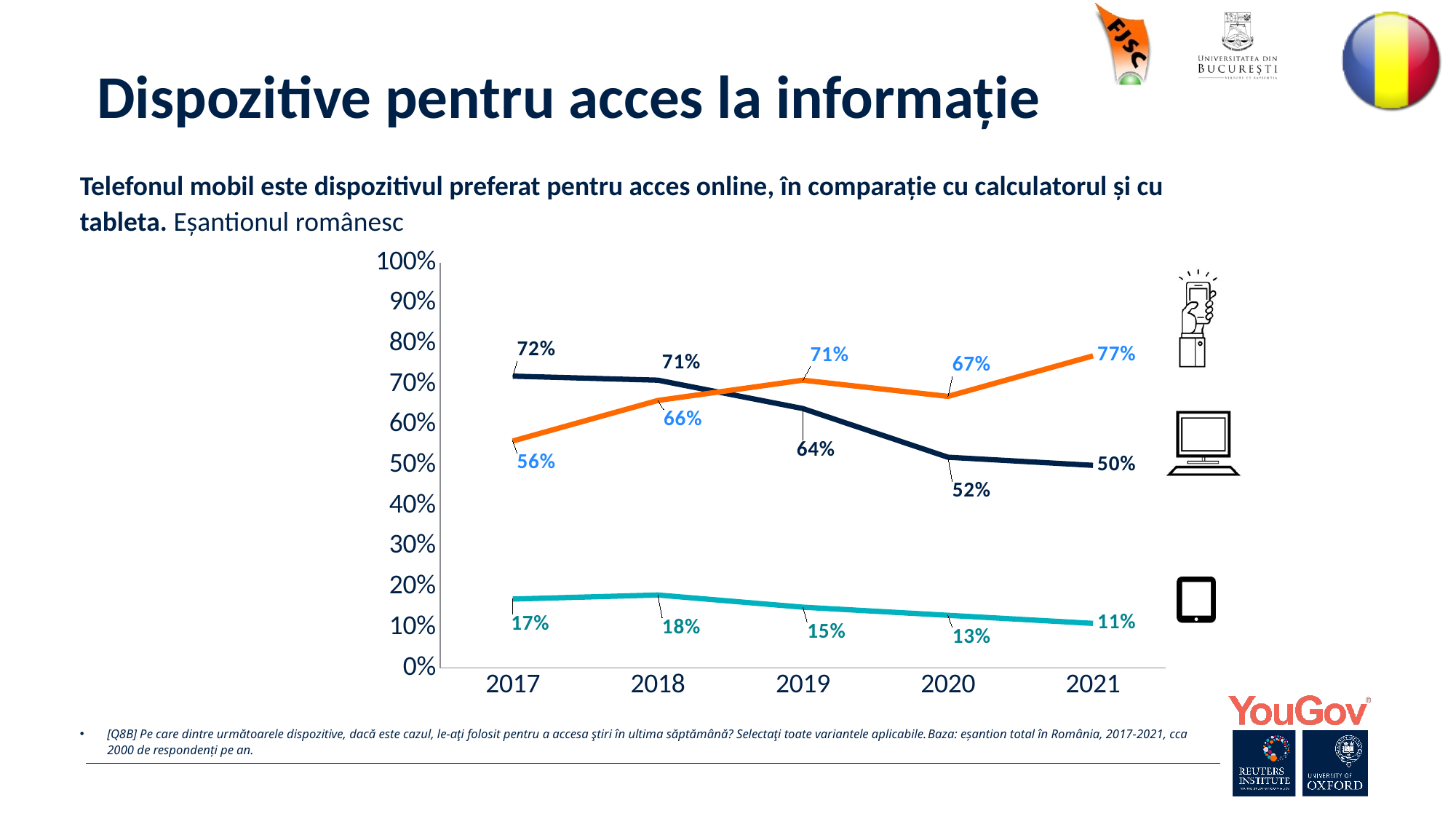
What kind of chart is shown on the slide? line chart Does the dark blue line (computer icon) rise or fall from 2017 to 2021? fall What is the difference between the orange line and the dark blue line in 2021? 27% How many lines (series) are plotted on the chart? 3 What is the title of the slide? Dispozitive pentru acces la informație What is the value of the teal line (tablet icon) in 2019? 15% In which year does the teal line (tablet icon) have its lowest value? 2021 What is the value of the dark blue line (computer icon) in 2017? 72% In which year does the orange line (smartphone icon) reach its highest value? 2021 How many years are plotted along the x axis? 5 In 2018, which is larger: the dark blue line (computer icon) or the orange line (smartphone icon)? the dark blue line (computer icon) What is the value of the orange line (smartphone icon) in 2021? 77%